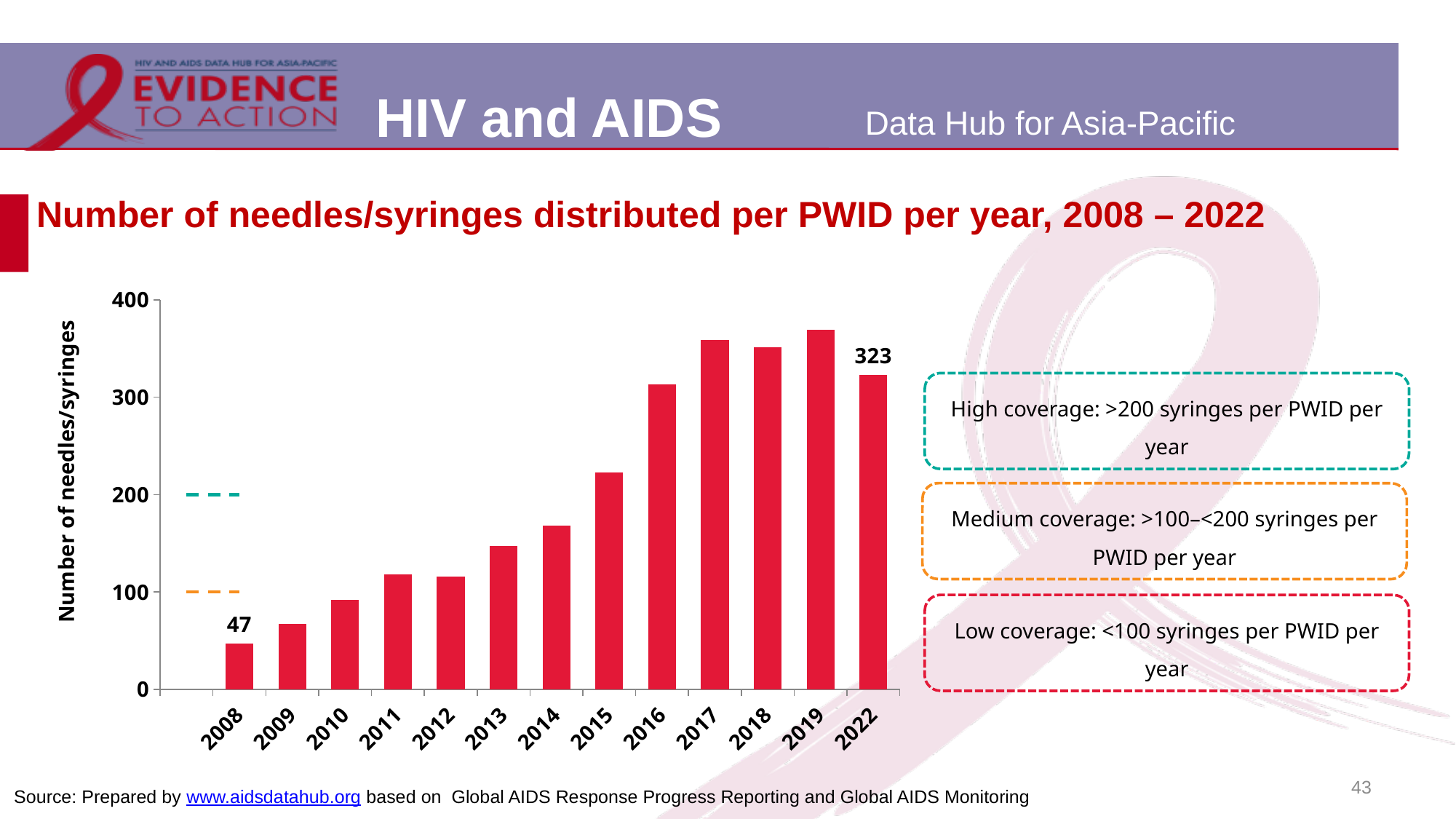
What is the difference between the 2022 value and the 2008 value? 276 Which year has the lowest number of needles/syringes distributed per PWID? 2008 How many years are shown on the x axis of the chart? 13 Is the value for 2010 greater or less than 100? less What is the number of needles/syringes distributed per PWID in 2008? 47 Do the values generally rise or fall from 2008 to 2019? rise Is the value for 2013 greater or less than 200? less Is the value for 2015 greater or less than 200? greater Which year has the larger value, 2016 or 2017? 2017 What is the title of the y axis of the chart? Number of needles/syringes What is the number of needles/syringes distributed per PWID in 2022? 323 What kind of chart is shown on the slide? bar chart